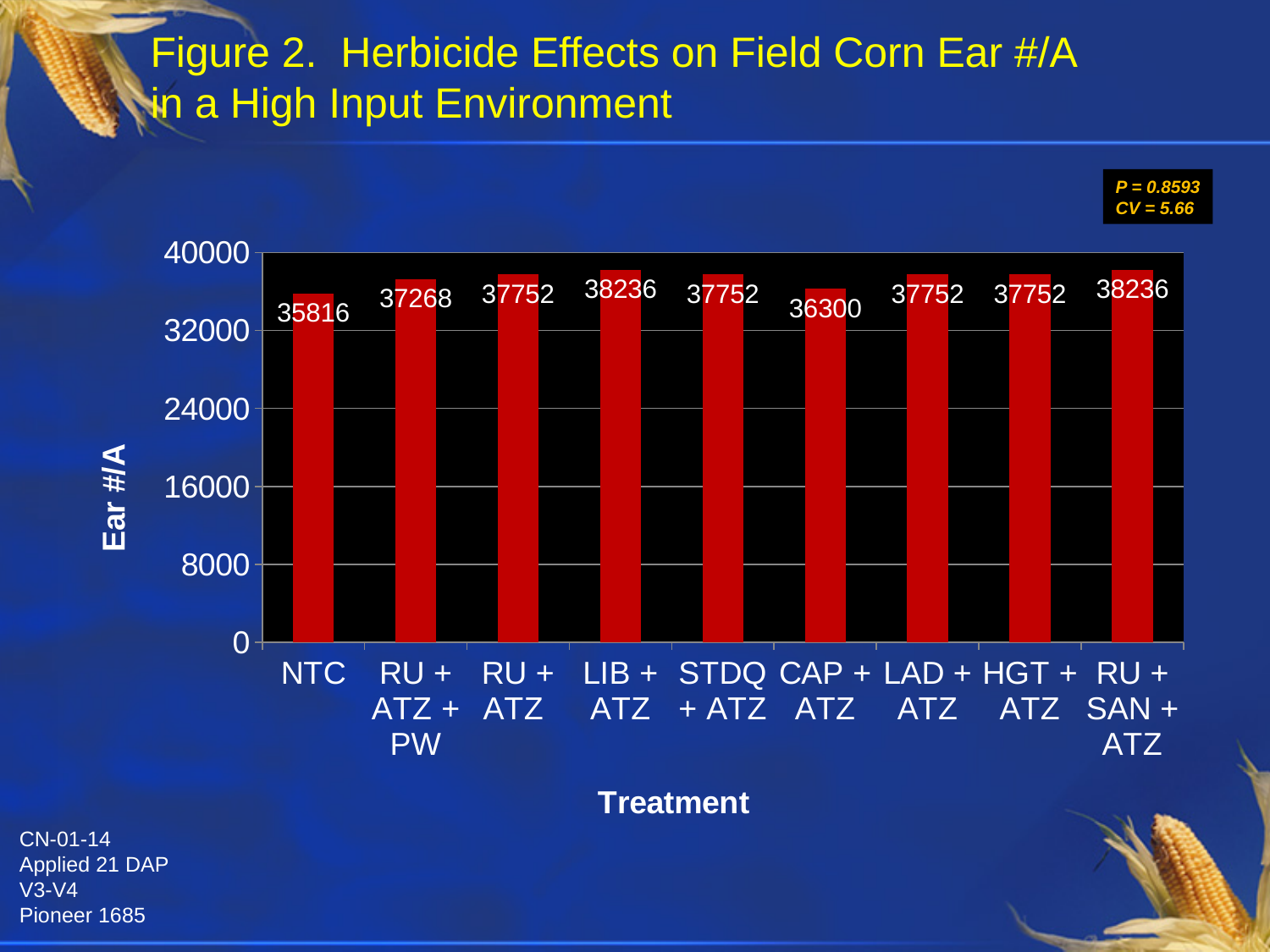
What is the Ear #/A value for the CAP + ATZ treatment? 36300 What is the difference in Ear #/A between the HGT + ATZ treatment and the CAP + ATZ treatment? 1452 What is the highest Ear #/A value shown on the chart? 38236 What is the Ear #/A value for the RU + ATZ + PW treatment? 37268 How many treatments are shown on the chart? 9 What kind of chart is shown on the slide? Bar chart Is the Ear #/A value for the NTC treatment greater or less than 32000? greater Which treatment has the lowest Ear #/A value? NTC What is the difference in Ear #/A between the LIB + ATZ treatment and the NTC treatment? 2420 Which has a larger Ear #/A value, RU + ATZ + PW or RU + SAN + ATZ? RU + SAN + ATZ What is the Ear #/A value for the LIB + ATZ treatment? 38236 What is the Ear #/A value for the NTC treatment? 35816